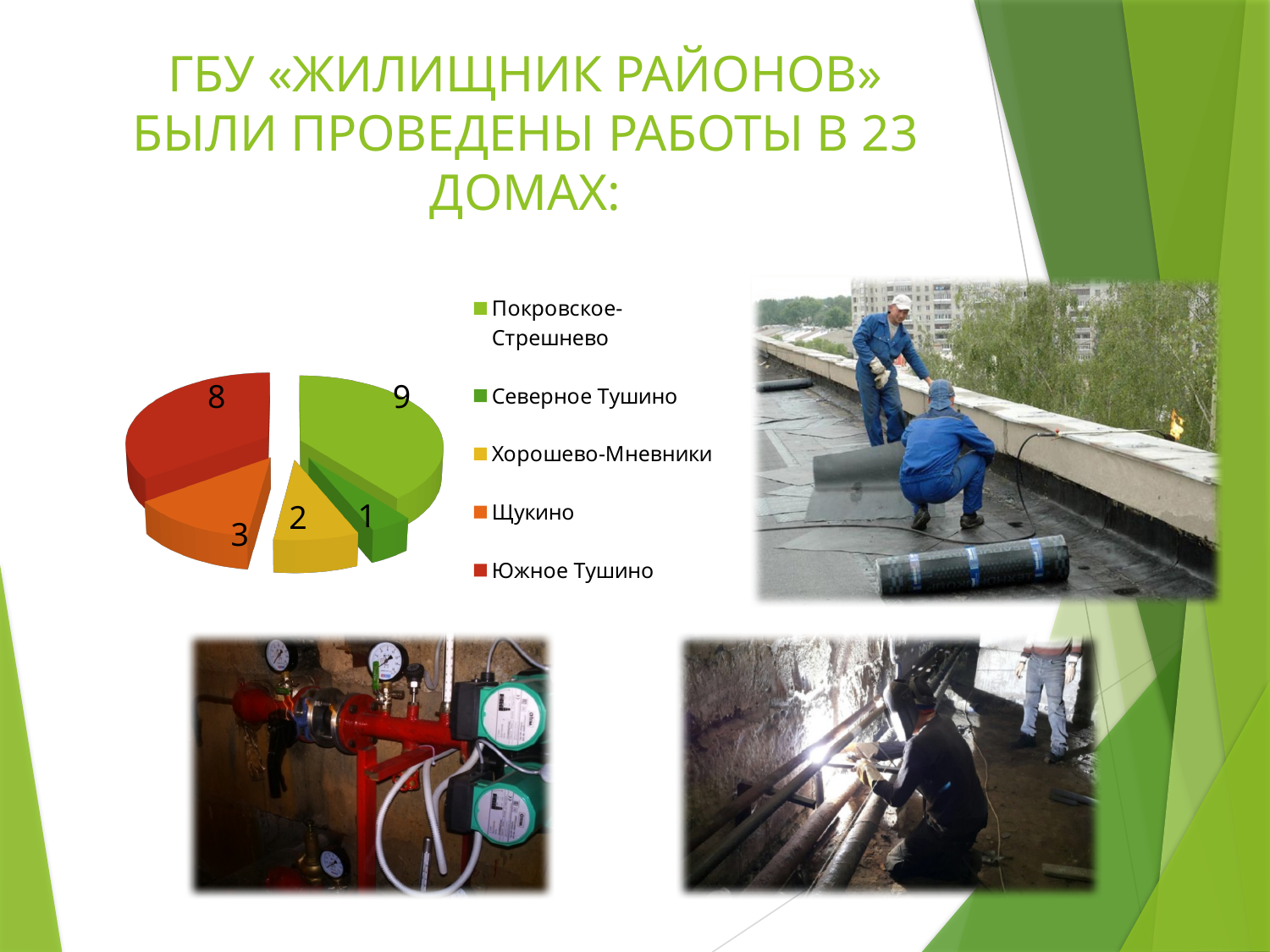
Which district has the largest slice in the pie chart? Покровское-Стрешнево What kind of chart is shown on the slide? pie chart What is the value for Щукино in the pie chart? 3 What colour is the slice for Южное Тушино in the pie chart? red What is the difference between the values for Покровское-Стрешнево and Южное Тушино? 1 How many entries does the legend of the pie chart list? 5 What is the value for Северное Тушино in the pie chart? 1 What is the value for Южное Тушино in the pie chart? 8 Which district has the smallest slice in the pie chart? Северное Тушино How many slices does the pie chart have? 5 Which is larger in the pie chart, Щукино or Хорошево-Мневники? Щукино What is the value for Покровское-Стрешнево in the pie chart? 9